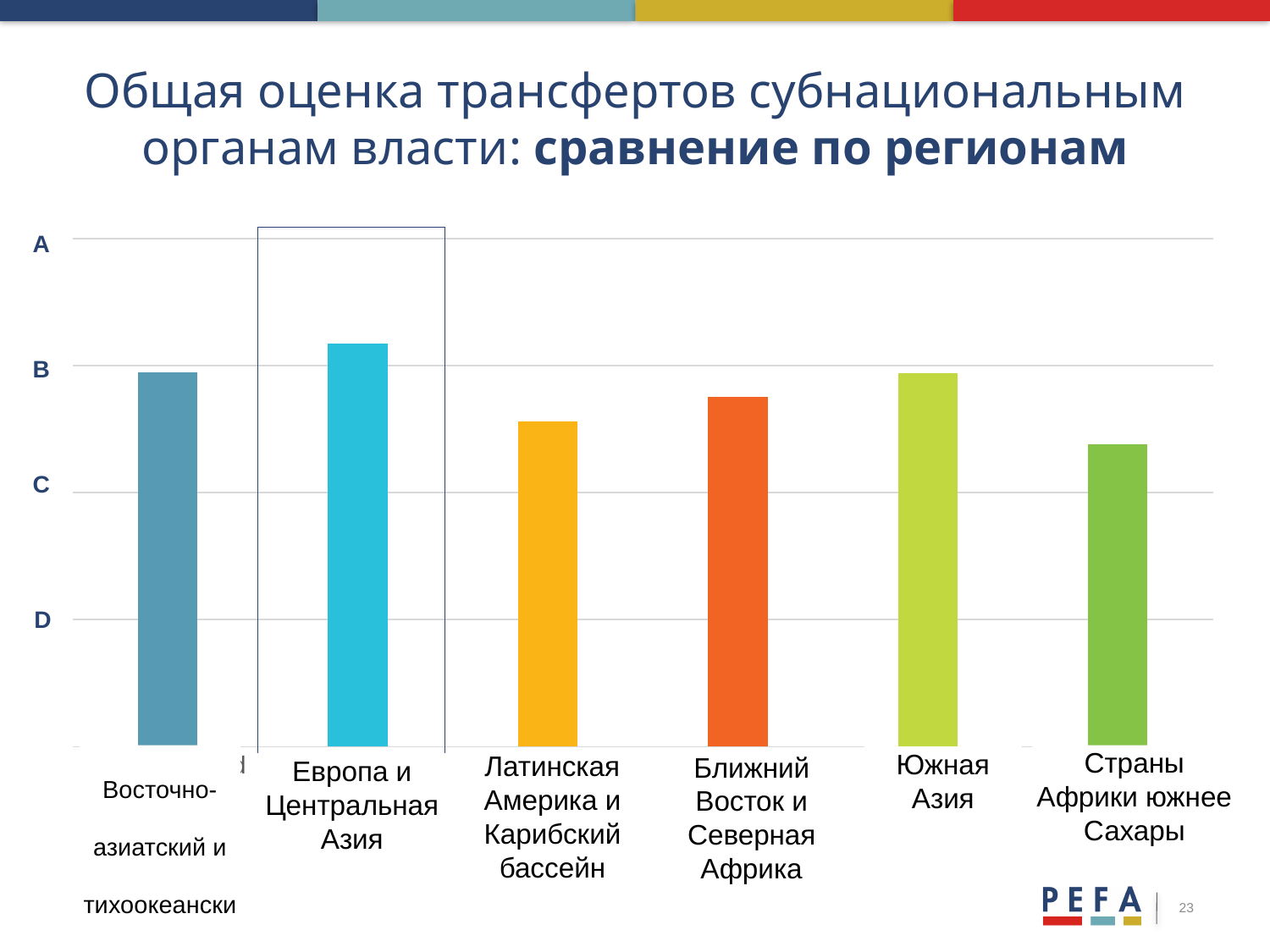
Which bar is taller: Европа и Центральная Азия or Латинская Америка и Карибский бассейн? Европа и Центральная Азия Is the bar for Страны Африки южнее Сахары above or below the B gridline? below Which region has the lowest bar in the chart? Страны Африки южнее Сахары Which bar is taller: Ближний Восток и Северная Африка or Страны Африки южнее Сахары? Ближний Восток и Северная Африка Is the bar for Латинская Америка и Карибский бассейн above or below the C gridline? above Is the bar for Европа и Центральная Азия above or below the B gridline? above What kind of chart is shown on the slide? bar chart Which region's bar is outlined with a rectangle on the chart? Европа и Центральная Азия What labels are shown on the vertical axis of the chart? A, B, C, D Which region has the highest bar in the chart? Европа и Центральная Азия How many regions are plotted in the chart? 6